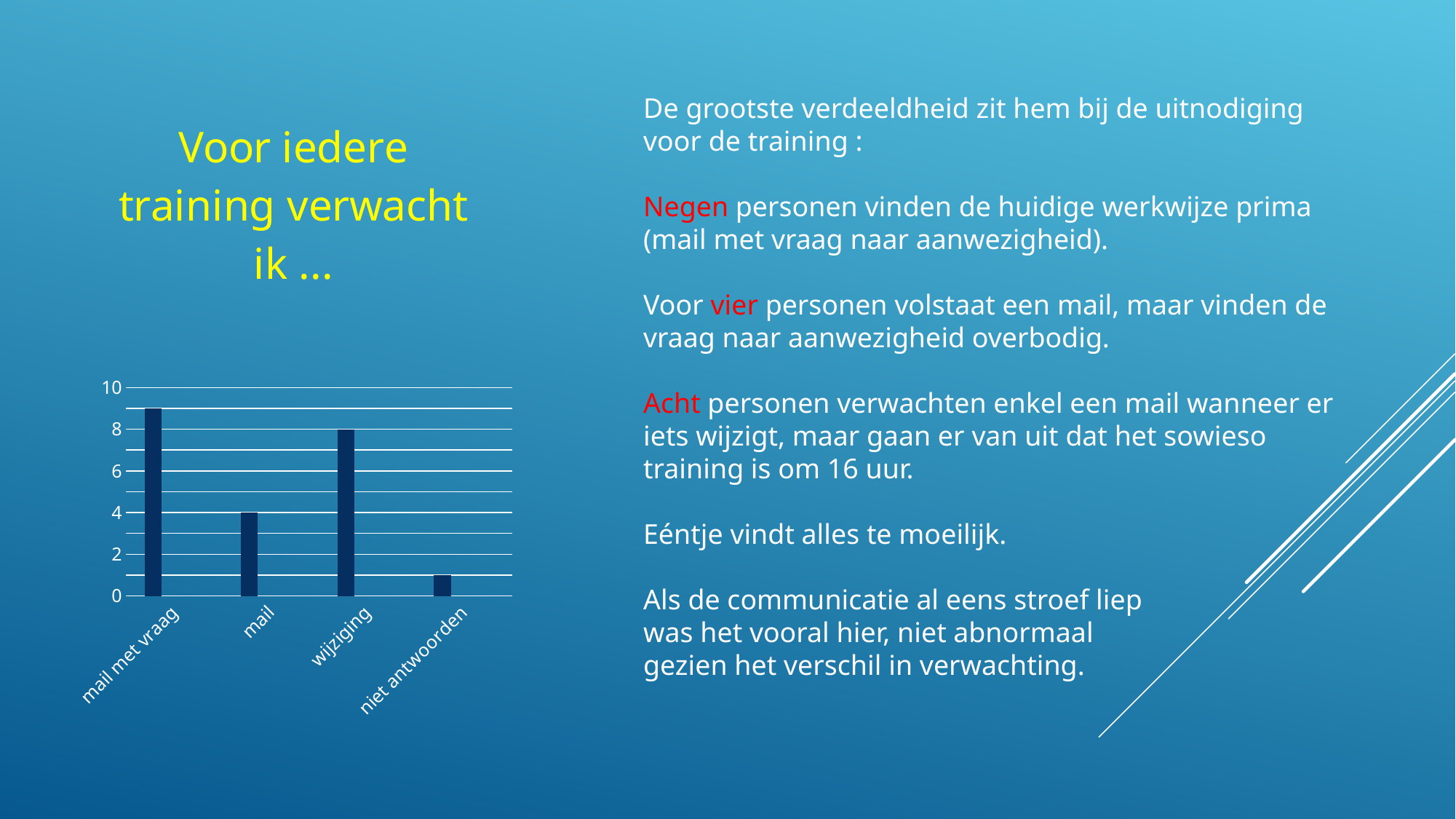
What is the difference between the values for "wijziging" and "mail"? 4 How many categories are shown on the x axis of the chart? 4 What is the highest value labelled on the vertical axis of the chart? 10 Is the value for "mail met vraag" greater or less than 8? greater What is the value for "wijziging" in the chart? 8 Which is larger, the value for "mail" or the value for "wijziging"? wijziging What kind of chart is shown on the slide? bar chart Which category has the lowest bar in the chart? niet antwoorden Which category has the highest bar in the chart? mail met vraag What colour are the bars in the chart? dark blue Is the value for "niet antwoorden" greater or less than 2? less What is the value for "mail" in the chart? 4